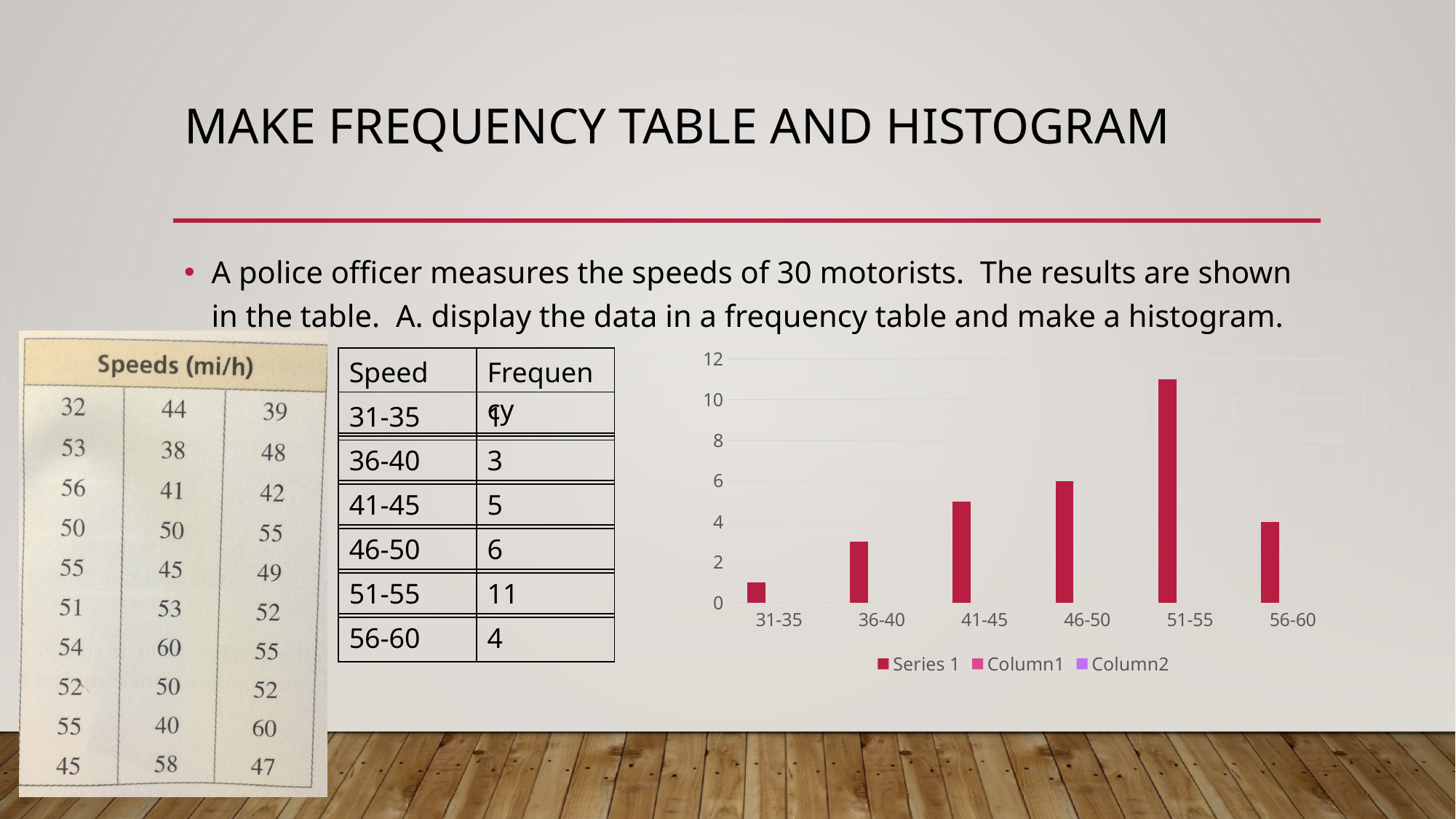
Which has a larger frequency, 41-45 or 56-60? 41-45 What is the difference between the frequencies for 51-55 and 46-50? 5 How many speed categories are shown on the x axis of the chart? 6 What is the frequency for the 46-50 speed category? 6 What type of chart is shown on the slide? bar chart How many series does the chart's legend list? 3 Do the values rise or fall along the x axis from 31-35 to 51-55? rise Which speed category has the highest frequency in the chart? 51-55 Is the value for 51-55 greater or less than 10? greater Which speed category has the lowest frequency in the chart? 31-35 What is the frequency for the 51-55 speed category? 11 What is the frequency for the 56-60 speed category? 4